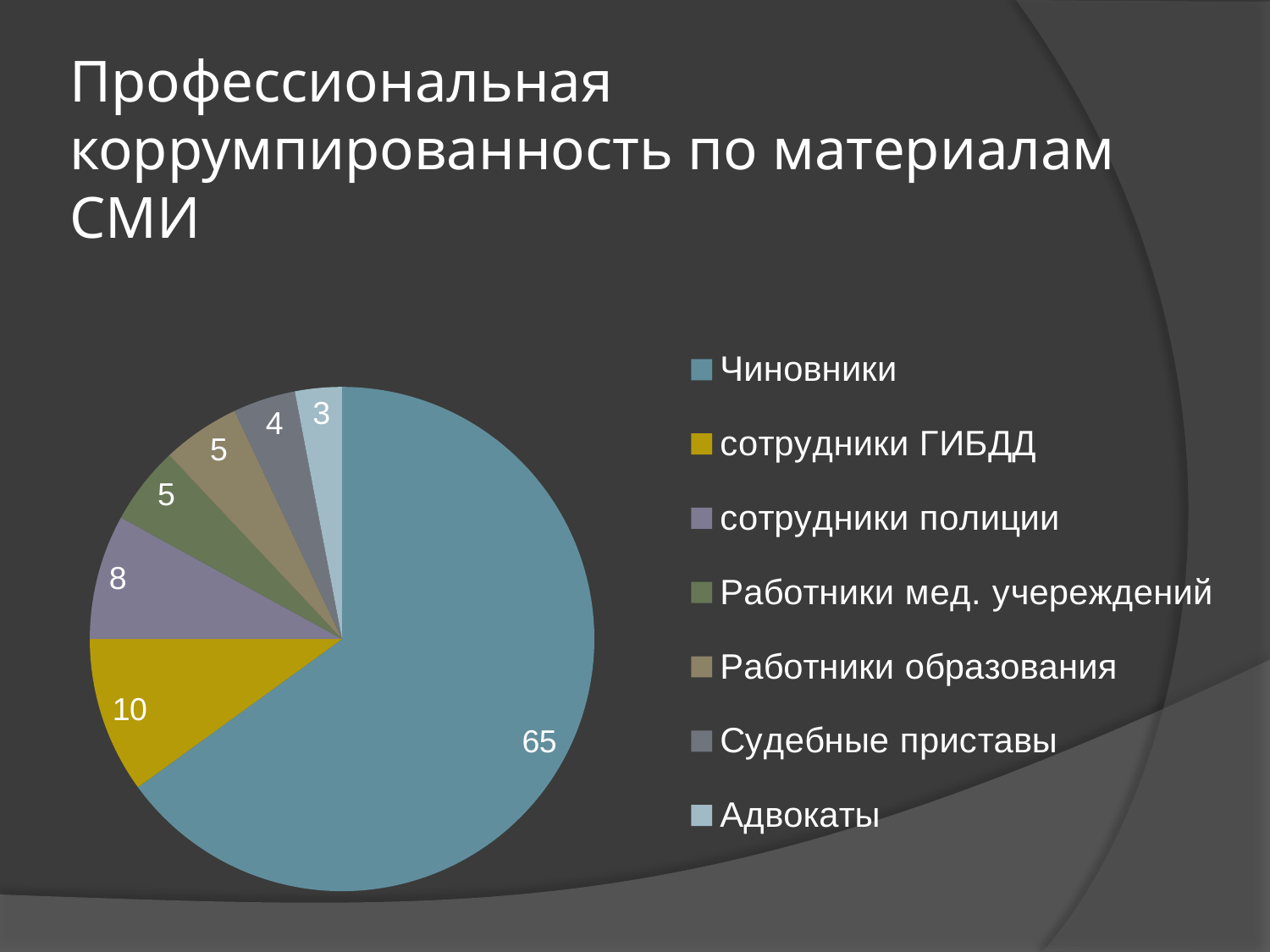
What is the value for Судебные приставы? 4 Which is larger, the value for сотрудники полиции or the value for Судебные приставы? сотрудники полиции How many categories does the pie chart have? 7 Which category has the largest slice of the pie? Чиновники What share of the pie does the Чиновники slice represent? 65% What is the value for Чиновники? 65 What is the value for сотрудники полиции? 8 What is the value for сотрудники ГИБДД? 10 Which category has the smallest slice of the pie? Адвокаты What kind of chart is shown on the slide? pie chart What is the difference between the values for Чиновники and сотрудники ГИБДД? 55 What is the value for Адвокаты? 3